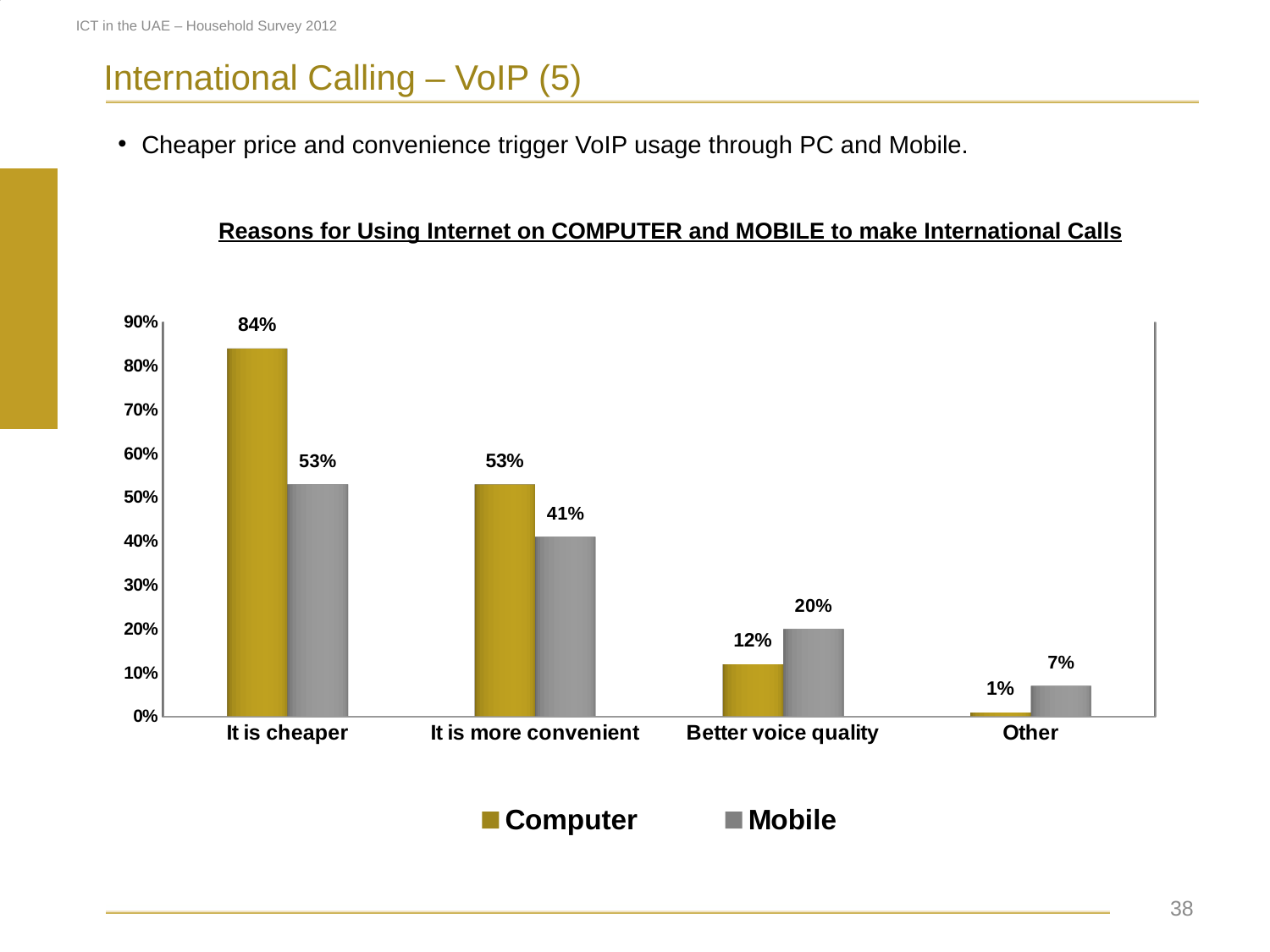
For "Better voice quality", which series has the larger value, Computer or Mobile? Mobile What is the Computer value for "Other"? 1% What is the difference between the Computer and Mobile values for "It is cheaper"? 31% Which category has the highest Mobile value? It is cheaper How many categories are shown on the x axis? 4 How many series does the legend list? 2 What is the Mobile value for "Better voice quality"? 20% What kind of chart is shown on the slide? Bar chart Which category has the lowest Computer value? Other What is the title of the chart? Reasons for Using Internet on COMPUTER and MOBILE to make International Calls What is the difference between the Computer and Mobile values for "It is more convenient"? 12% What is the Computer value for "It is cheaper"? 84%